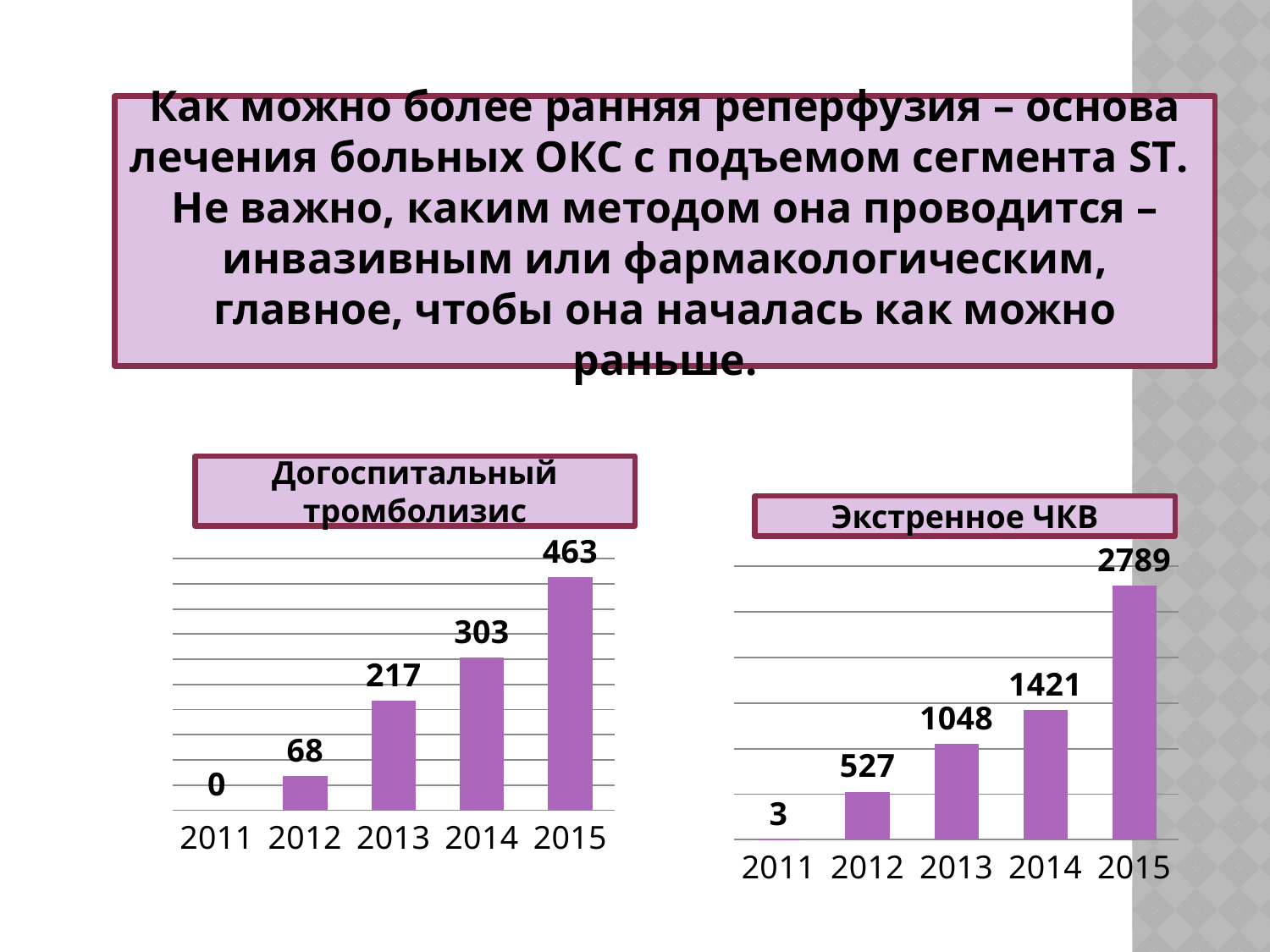
In the 'Догоспитальный тромболизис' chart, what is the value for 2012? 68 How many years are shown on the x axis of the 'Догоспитальный тромболизис' chart? 5 In the 'Экстренное ЧКВ' chart, what is the value for 2011? 3 In the 'Экстренное ЧКВ' chart, what is the value for 2013? 1048 In the 'Экстренное ЧКВ' chart, what is the difference between the values for 2015 and 2014? 1368 In the 'Догоспитальный тромболизис' chart, do the values rise or fall from 2011 to 2015? rise In the 'Экстренное ЧКВ' chart, which year has the highest value? 2015 In the 'Догоспитальный тромболизис' chart, which year has the lowest value? 2011 What kind of chart is the 'Экстренное ЧКВ' chart? bar chart In the 'Догоспитальный тромболизис' chart, what is the difference between the values for 2014 and 2013? 86 In the 'Догоспитальный тромболизис' chart, what is the value for 2015? 463 In the 'Экстренное ЧКВ' chart, which is larger, the value for 2012 or the value for 2013? 2013